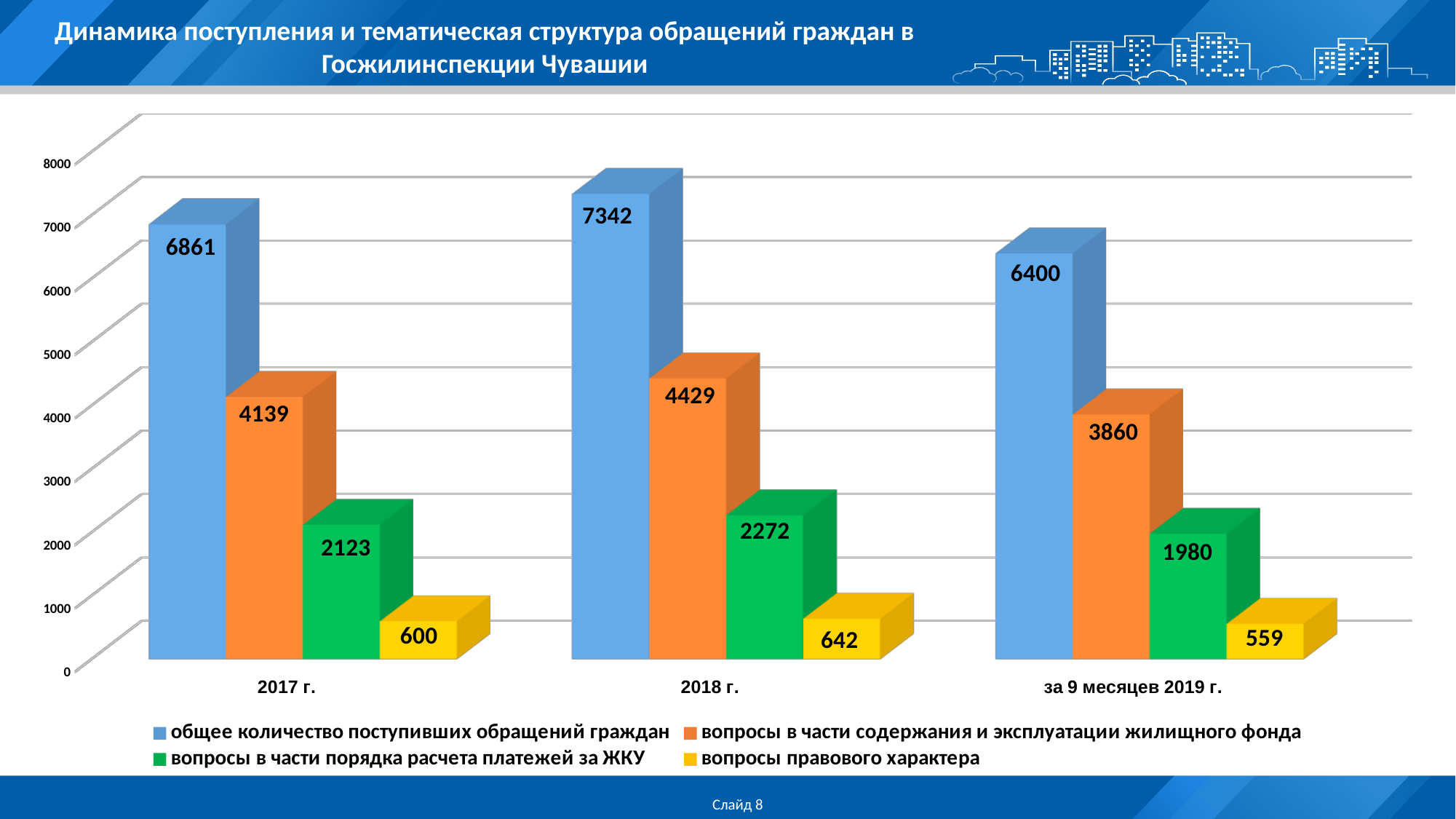
In which period was the total number of received appeals (общее количество поступивших обращений граждан) highest? 2018 г. What kind of chart is shown on the slide? bar chart Which colour represents вопросы в части порядка расчета платежей за ЖКУ in the legend? green In which period was the value for вопросы в части порядка расчета платежей за ЖКУ lowest? за 9 месяцев 2019 г. What is the value for вопросы правового характера for за 9 месяцев 2019 г.? 559 What is the value for вопросы в части содержания и эксплуатации жилищного фонда in 2017 г.? 4139 How many series does the legend list? 4 How many periods (categories) are shown on the x axis? 3 Which is larger: вопросы правового характера in 2018 г. or in 2017 г.? 2018 г. What is the difference between the total number of received appeals in 2018 г. and in 2017 г.? 481 Is the value for вопросы в части содержания и эксплуатации жилищного фонда for за 9 месяцев 2019 г. greater or less than 4000? less What was the total number of citizen appeals received (общее количество поступивших обращений граждан) in 2018 г.? 7342